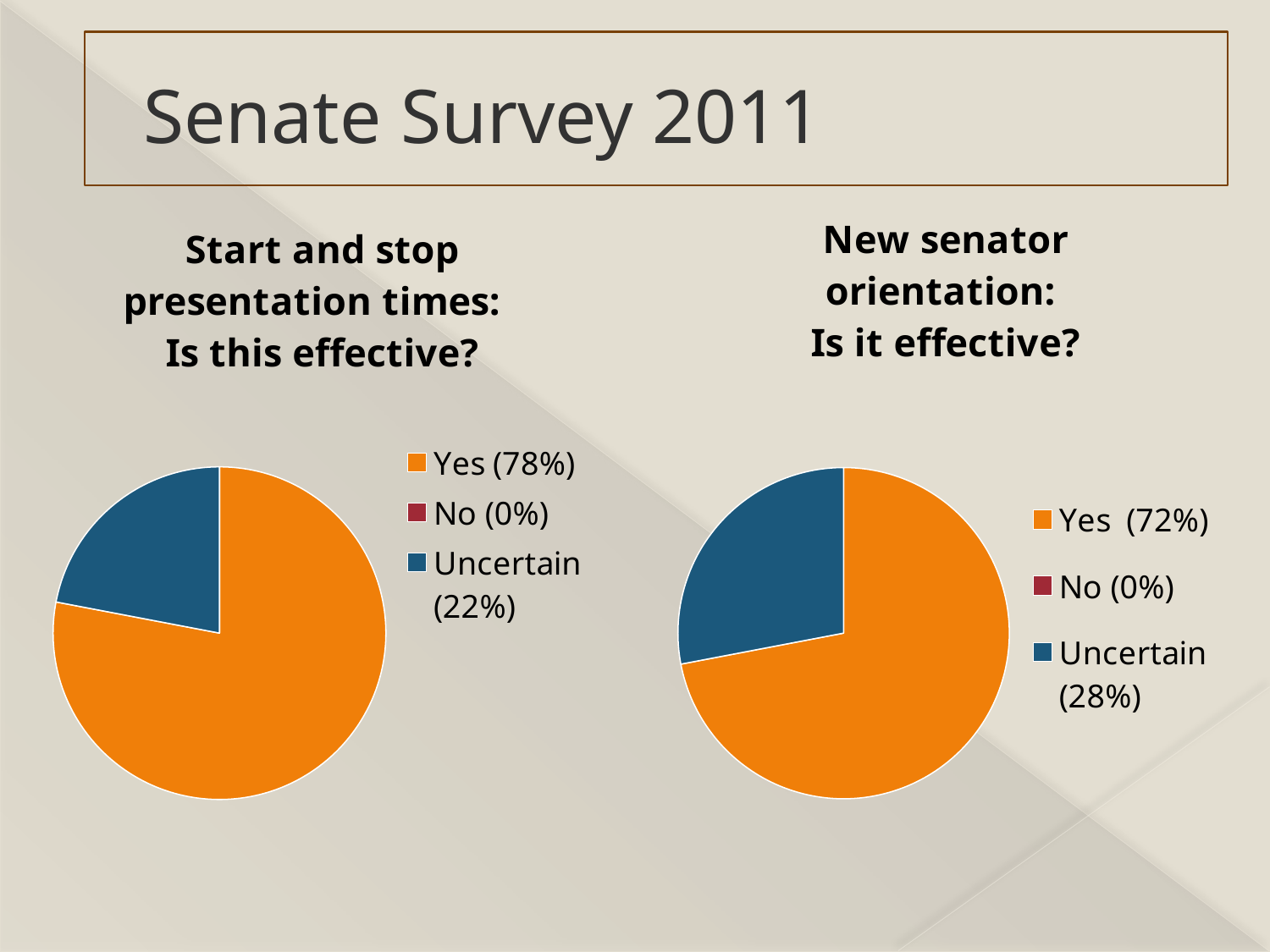
In the 'New senator orientation: Is it effective?' chart, what share of responses is Yes? 72% In the 'New senator orientation: Is it effective?' chart, which response has the smallest share? No In the 'Start and stop presentation times: Is this effective?' chart, which response has the largest share? Yes What kind of chart is the 'New senator orientation: Is it effective?' chart? Pie chart In the 'Start and stop presentation times: Is this effective?' chart, what is the difference between the Yes and Uncertain shares? 56% In the 'New senator orientation: Is it effective?' chart, what colour is the Yes slice? Orange In the 'New senator orientation: Is it effective?' chart, what share of responses is Uncertain? 28% In the 'Start and stop presentation times: Is this effective?' chart, what share of responses is Uncertain? 22% Which chart has the larger Uncertain share, 'Start and stop presentation times' or 'New senator orientation'? New senator orientation In the 'New senator orientation: Is it effective?' chart, what share of responses is No? 0% How many entries does the legend of the 'Start and stop presentation times: Is this effective?' chart list? 3